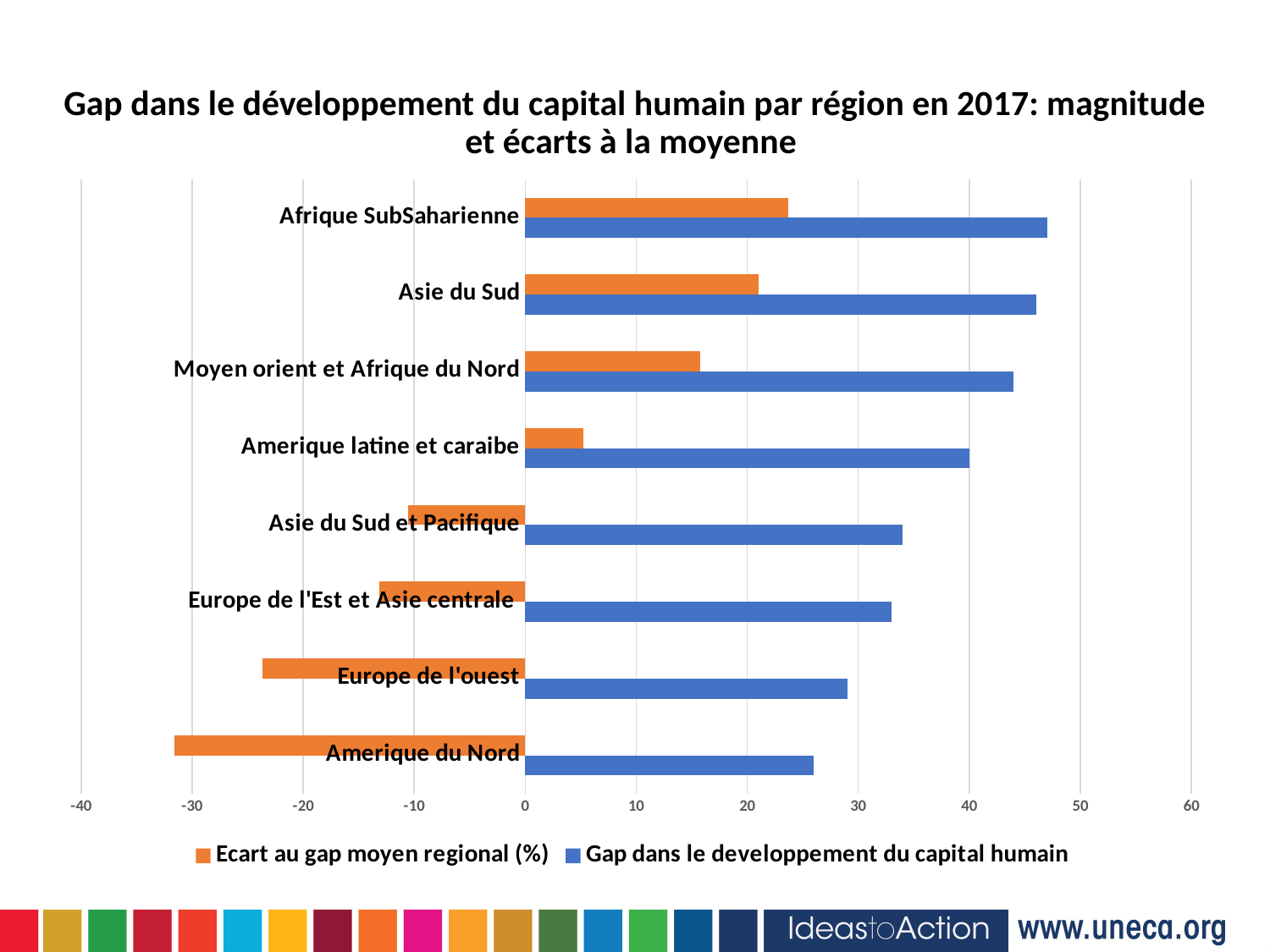
How many series does the legend list? 2 Which region has the lowest value for 'Ecart au gap moyen regional (%)'? Amerique du Nord Which colour represents the series 'Ecart au gap moyen regional (%)' in the legend? orange Is the 'Gap dans le developpement du capital humain' value for Amerique du Nord greater or less than 30? less Is the 'Ecart au gap moyen regional (%)' value for Amerique du Nord greater or less than -30? less How many regions are listed on the chart? 8 Which region has the highest value for 'Ecart au gap moyen regional (%)'? Afrique SubSaharienne Which has the larger 'Gap dans le developpement du capital humain' value: Moyen orient et Afrique du Nord or Amerique latine et caraibe? Moyen orient et Afrique du Nord What kind of chart is shown on the slide? bar chart Is the 'Ecart au gap moyen regional (%)' value for Europe de l'ouest greater or less than -20? less Which region has the lowest value for 'Gap dans le developpement du capital humain'? Amerique du Nord